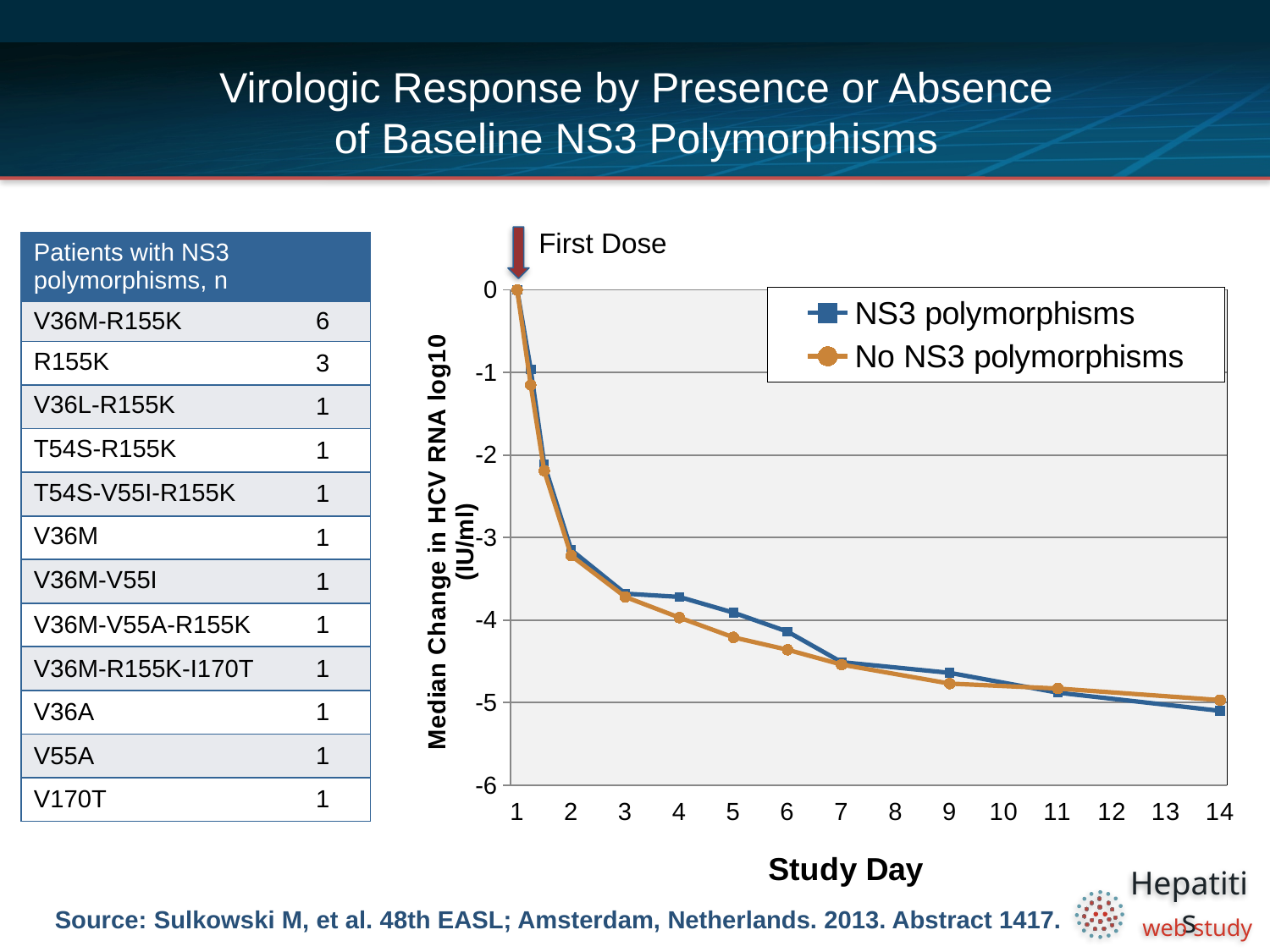
What is the value for NS3 polymorphisms on study day 1? 0 Is the value for NS3 polymorphisms on study day 7 greater or less than -4? less How many series does the chart legend list? 2 What are the two series named in the chart legend? NS3 polymorphisms; No NS3 polymorphisms What is the value for No NS3 polymorphisms on study day 1? 0 What kind of chart is shown on the slide? line chart How many study days are labelled on the x axis of the chart? 14 What is the title of the chart's x axis? Study Day On study day 4, which series has the higher (less negative) value, NS3 polymorphisms or No NS3 polymorphisms? NS3 polymorphisms Do the values for NS3 polymorphisms rise or fall as the study day increases? fall Is the value for No NS3 polymorphisms on study day 9 greater or less than -5? greater Is the value for No NS3 polymorphisms on study day 3 greater or less than -3? less